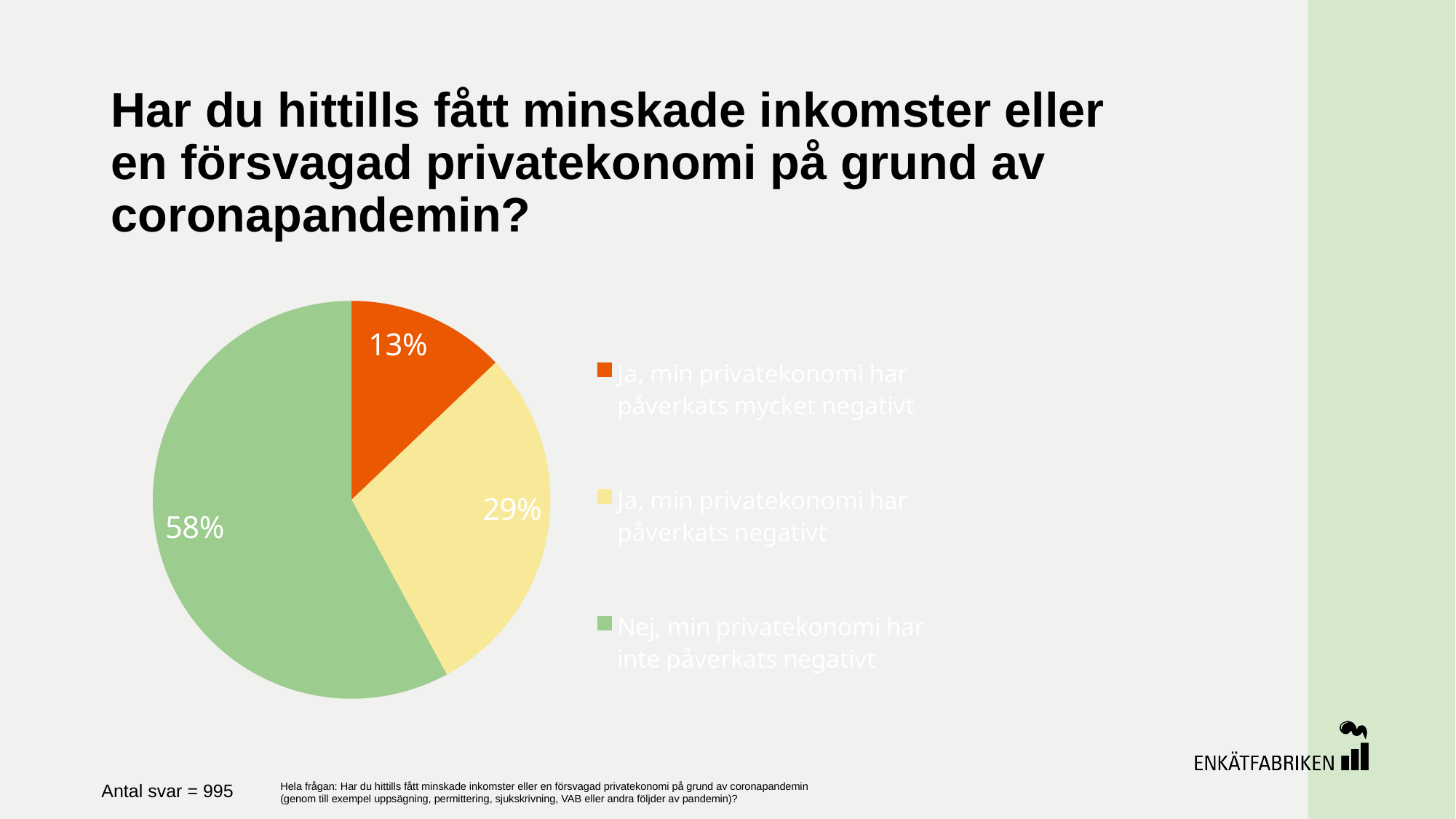
Which answer option has the largest slice of the pie? Nej, min privatekonomi har inte påverkats negativt What is the difference in percentage points between the "Nej, min privatekonomi har inte påverkats negativt" slice and the "Ja, min privatekonomi har påverkats negativt" slice? 29 percentage points What is the combined share of the two "Ja" answer options? 42% How many slices does the pie chart have? 3 How many responses (Antal svar) does the slide report? 995 What share of respondents answered "Ja, min privatekonomi har påverkats negativt"? 29% Which is larger: the share for "Ja, min privatekonomi har påverkats negativt" or the share for "Ja, min privatekonomi har påverkats mycket negativt"? Ja, min privatekonomi har påverkats negativt Which answer option has the smallest slice of the pie? Ja, min privatekonomi har påverkats mycket negativt What colour is the slice for "Ja, min privatekonomi har påverkats mycket negativt"? Orange What share of respondents answered "Nej, min privatekonomi har inte påverkats negativt"? 58% What kind of chart is shown on the slide? Pie chart What share of respondents answered "Ja, min privatekonomi har påverkats mycket negativt"? 13%